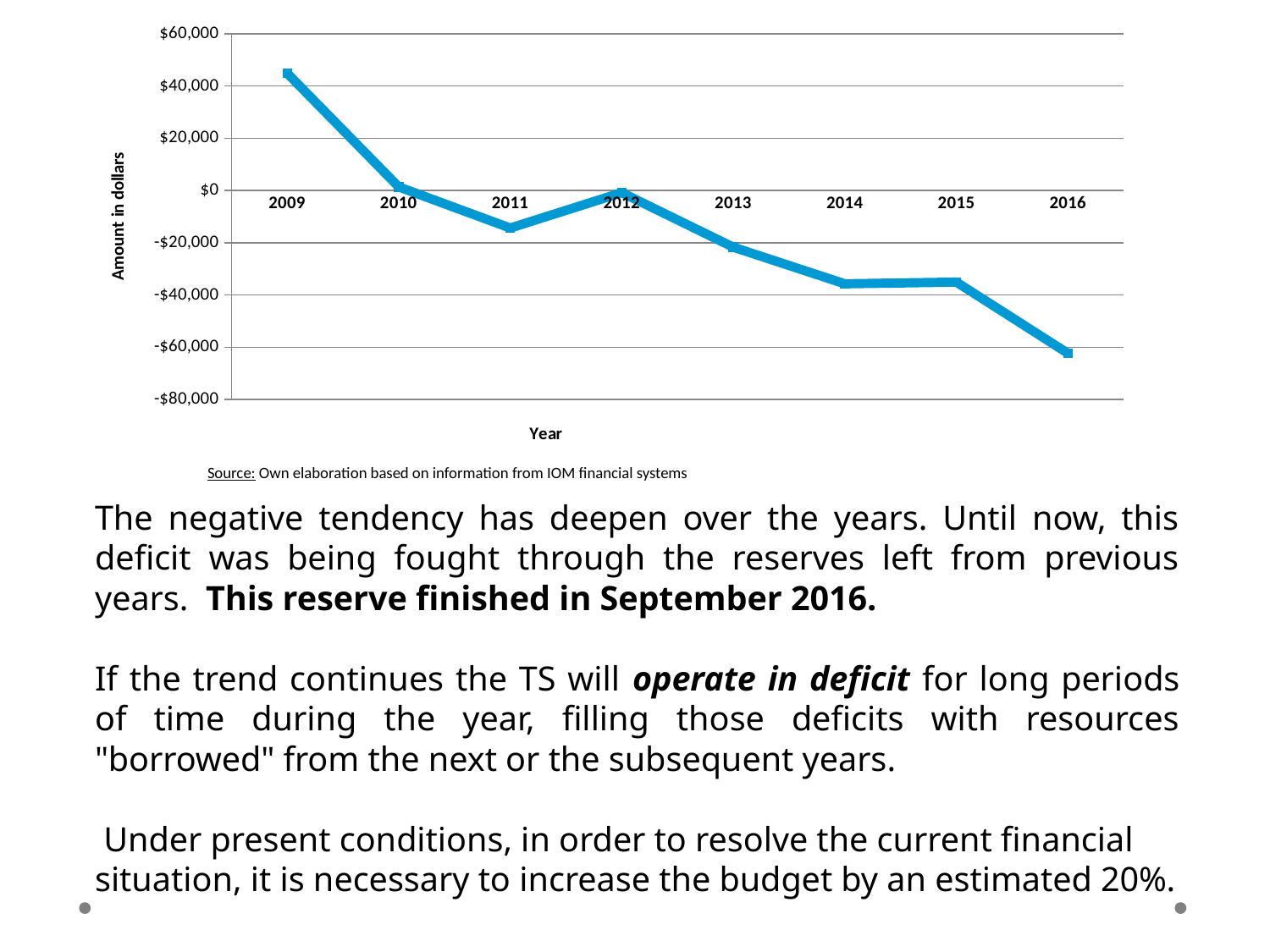
Is the value for 2014 greater or less than -$40,000? greater What is the title of the horizontal axis of the chart? Year Is the value for 2016 greater or less than -$60,000? less How many years are plotted on the x axis of the chart? 8 Overall, do the values rise or fall from 2009 to 2016? fall Is the value for 2009 greater or less than $40,000? greater Which year has the lowest value on the chart? 2016 Which year has the highest value on the chart? 2009 What is the title of the vertical axis of the chart? Amount in dollars What kind of chart is shown on the slide? line chart Which year has the larger value, 2013 or 2014? 2013